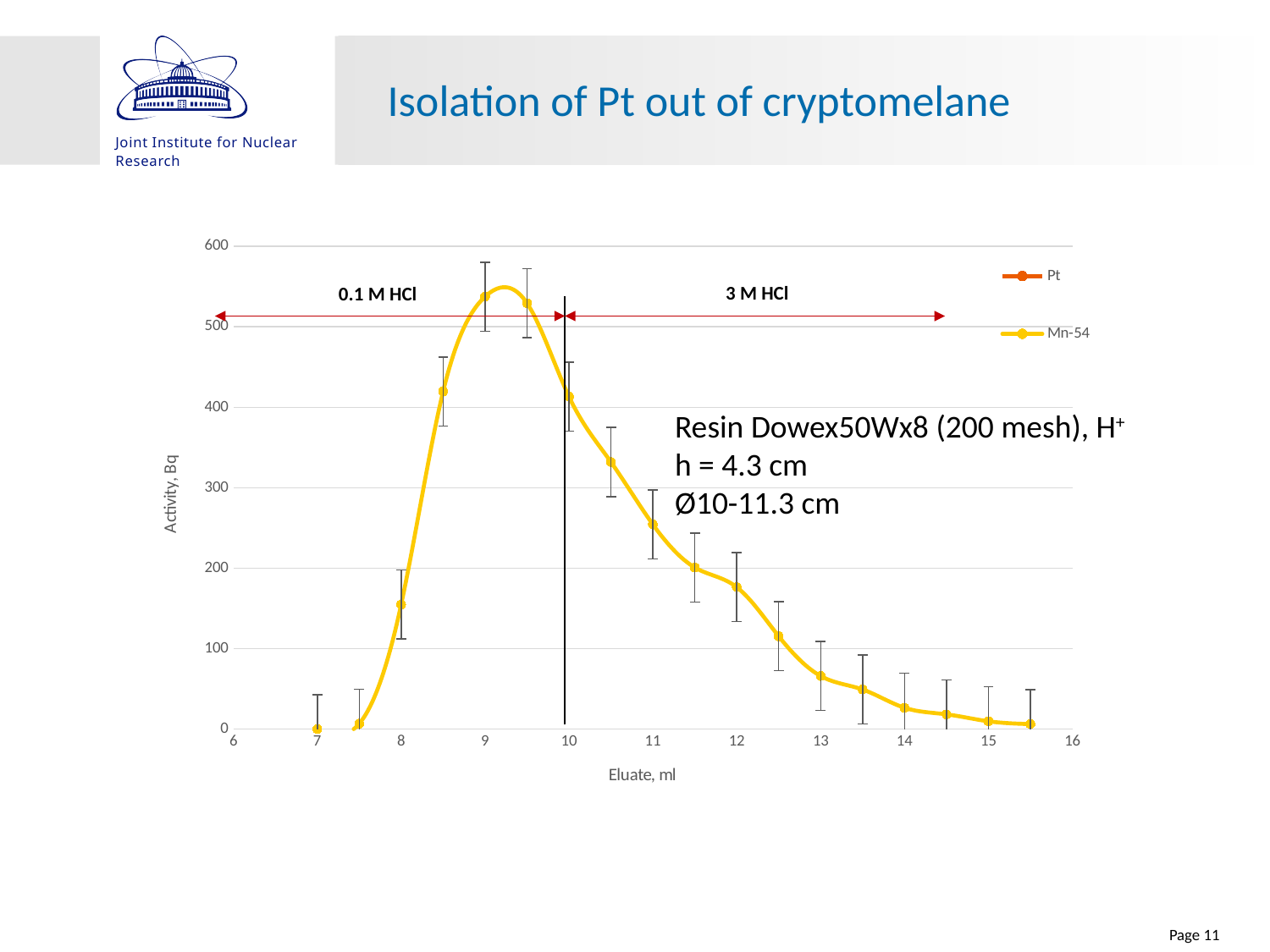
How many series does the chart legend list? 2 Do the Mn-54 activity values rise or fall as the eluate volume increases from 10 ml to 15.5 ml? fall Is the Mn-54 activity at 8.5 ml eluate greater or less than 400 Bq? greater What are the two series named in the chart legend? Pt and Mn-54 What is the label of the vertical axis of the chart? Activity, Bq What kind of chart is shown on the slide? line chart Is the Mn-54 activity at 11 ml eluate greater or less than 200 Bq? greater Which has the higher Mn-54 activity: 8 ml or 8.5 ml eluate? 8.5 ml Is the Mn-54 activity at 8 ml eluate greater or less than 200 Bq? less Which has the higher Mn-54 activity: 11 ml or 12 ml eluate? 11 ml